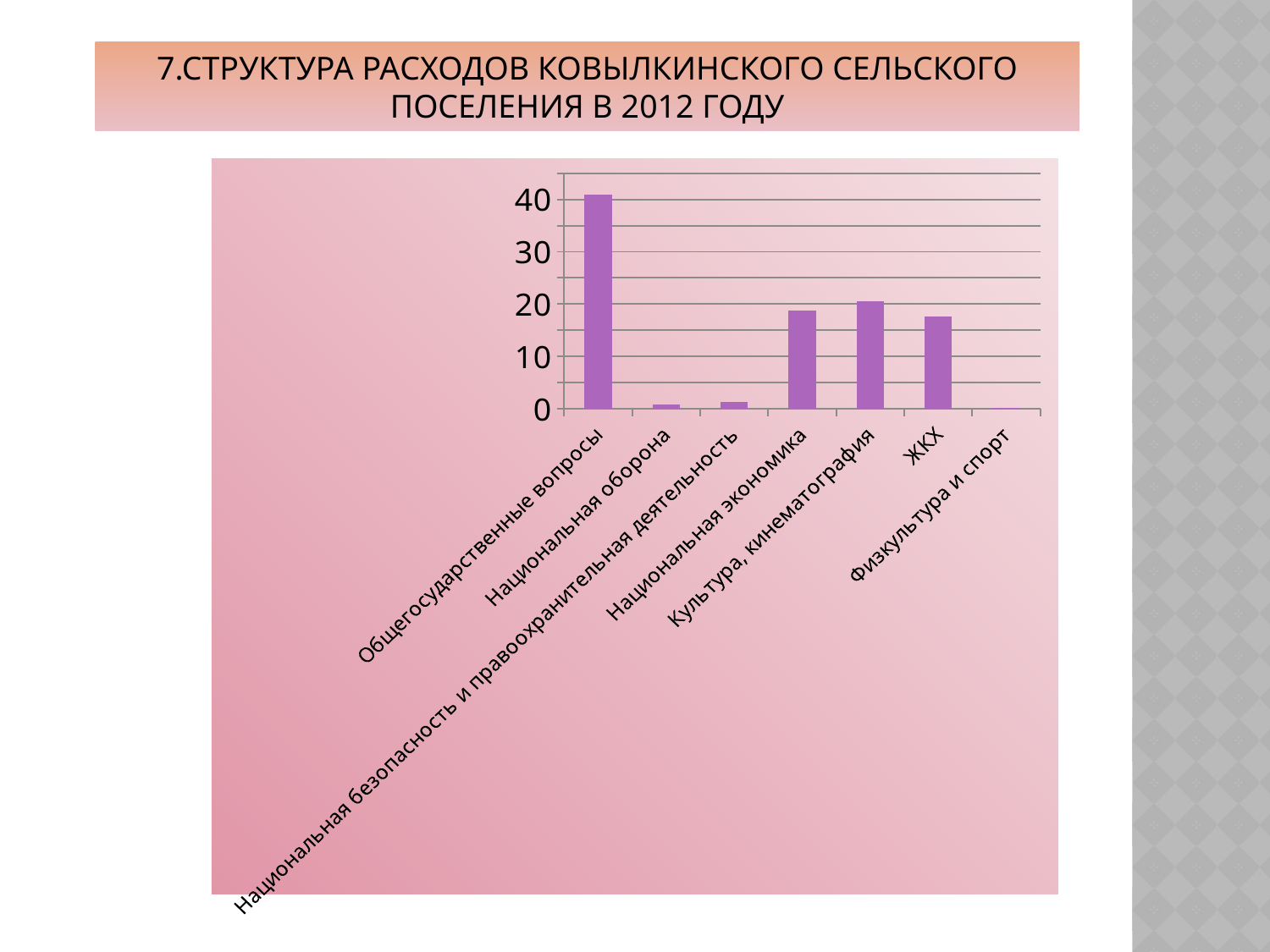
Is the value for Национальная экономика greater or less than 10? greater Which category has the highest value in the chart? Общегосударственные вопросы What colour are the bars in the chart? Purple Is the value for Общегосударственные вопросы greater or less than 30? greater Is the value for Культура, кинематография greater or less than 10? greater Which category has the lowest value in the chart? Физкультура и спорт How many categories are shown on the x axis of the chart? 7 What kind of chart is shown on the slide? Bar chart Which is larger, the value for Общегосударственные вопросы or the value for ЖКХ? Общегосударственные вопросы What is the title of the slide containing the chart? 7.СТРУКТУРА РАСХОДОВ КОВЫЛКИНСКОГО СЕЛЬСКОГО ПОСЕЛЕНИЯ В 2012 ГОДУ